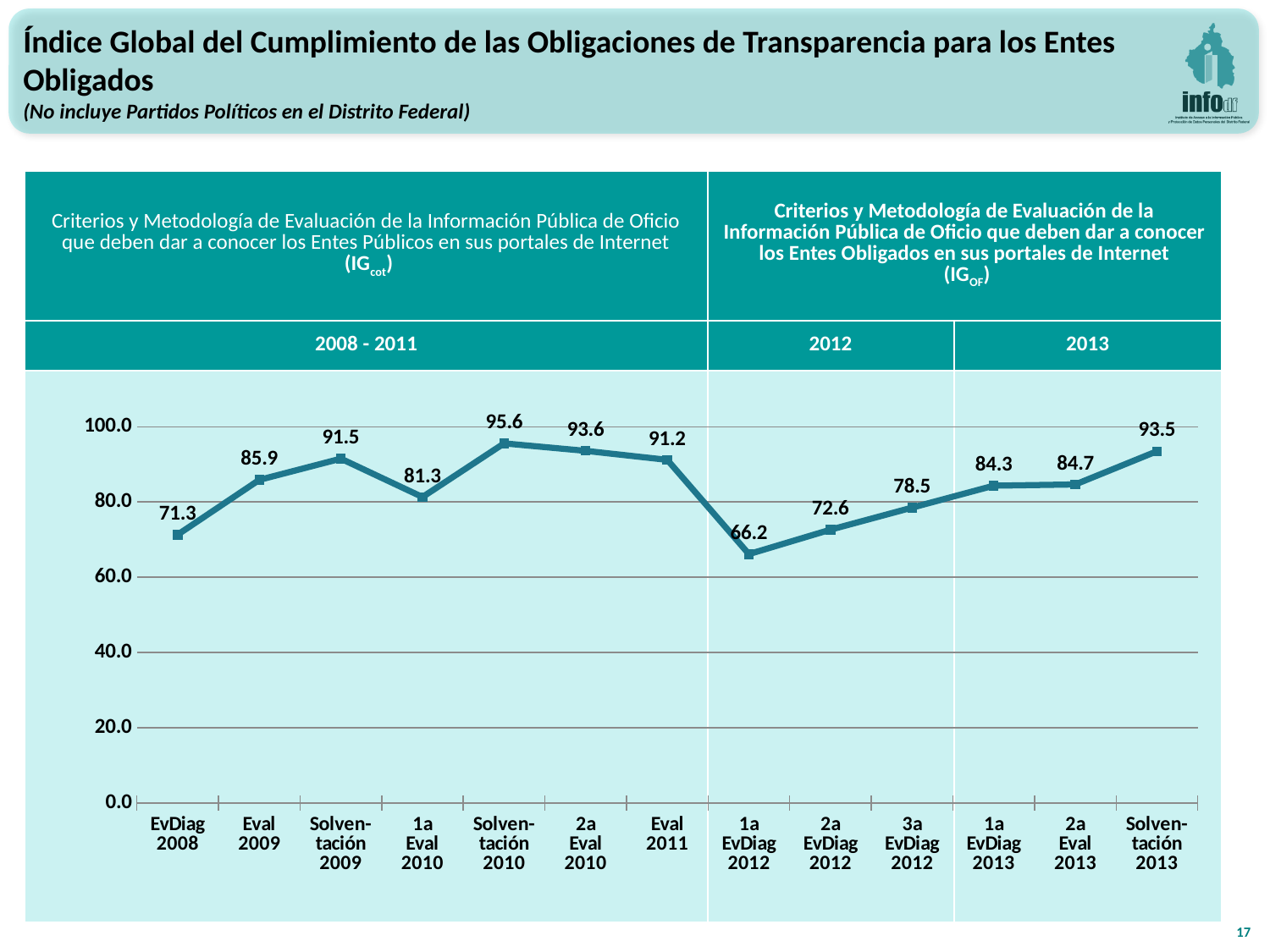
What is the value for 3a EvDiag 2012? 78.5 Do the values rise or fall from 1a EvDiag 2012 to Solventación 2013? rise Is the value for 2a EvDiag 2012 greater or less than 80.0? less What is the difference between the values for Solventación 2013 and 1a EvDiag 2012? 27.3 Which point on the chart has the highest value? Solventación 2010 What is the value for Solventación 2013? 93.5 What is the value for EvDiag 2008? 71.3 How many data points are plotted on the chart? 13 Which year periods are shown in the header bands above the chart? 2008 - 2011, 2012, 2013 Which is larger, the value for Eval 2009 or the value for 1a Eval 2010? Eval 2009 What kind of chart is shown on the slide? line chart Which point on the chart has the lowest value? 1a EvDiag 2012